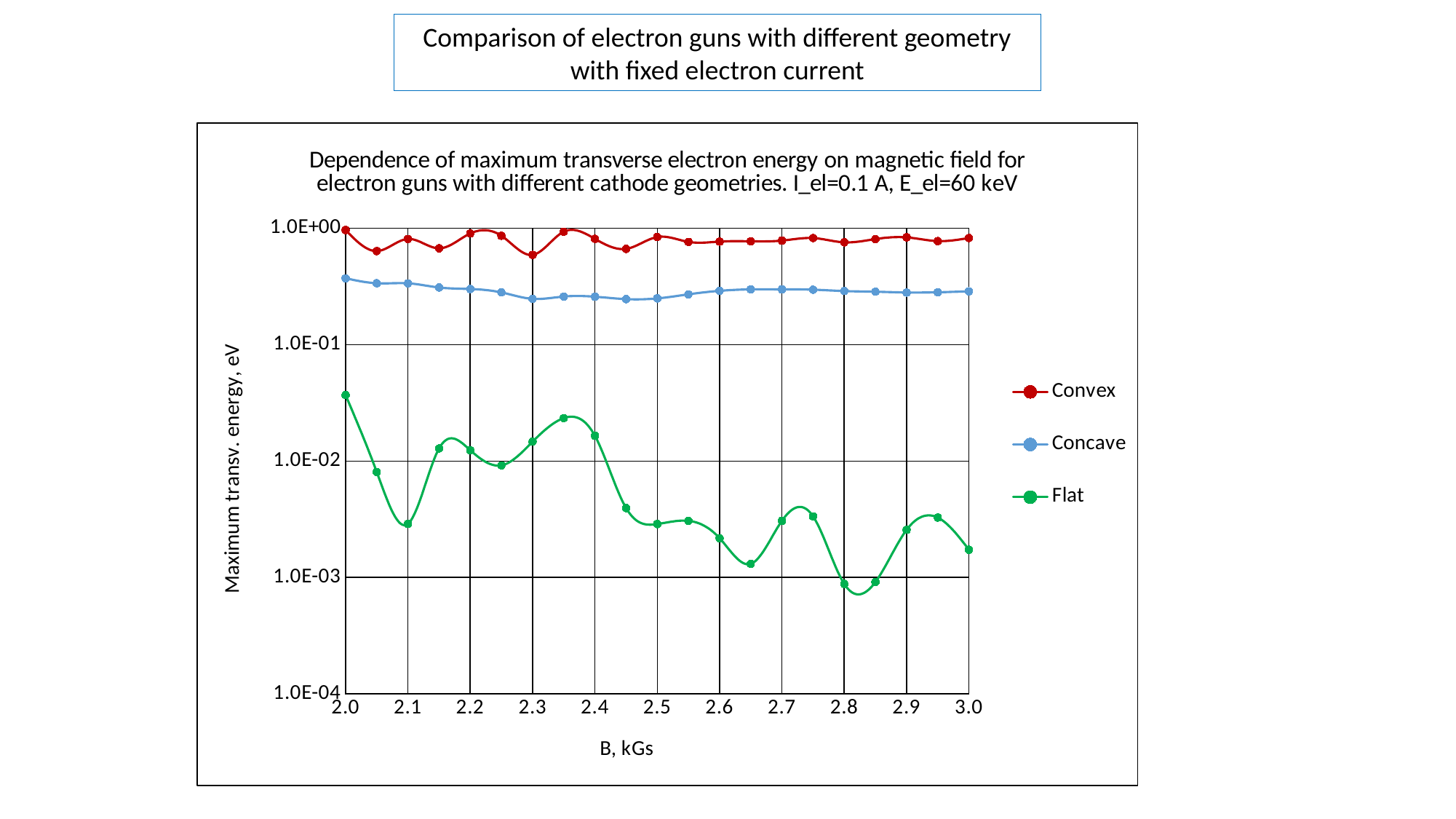
How many series does the legend list? 3 Is the value for the Flat series at B = 2.0 kGs greater or less than 1.0E-01? less What is the label of the x axis? B, kGs How many data points are plotted for the Convex series? 21 What kind of chart is shown on the slide? line chart At B = 2.5 kGs, which series has the larger value, Convex or Concave? Convex Which series has the lowest maximum transverse energy across the whole magnetic field range? Flat Does the Flat series generally rise or fall as B increases from 2.0 to 3.0 kGs? fall Which series has the highest maximum transverse energy across the whole magnetic field range? Convex Is the value for the Concave series at B = 2.0 kGs greater or less than 1.0E-01? greater At which value of B does the Flat series reach its highest point? 2.0